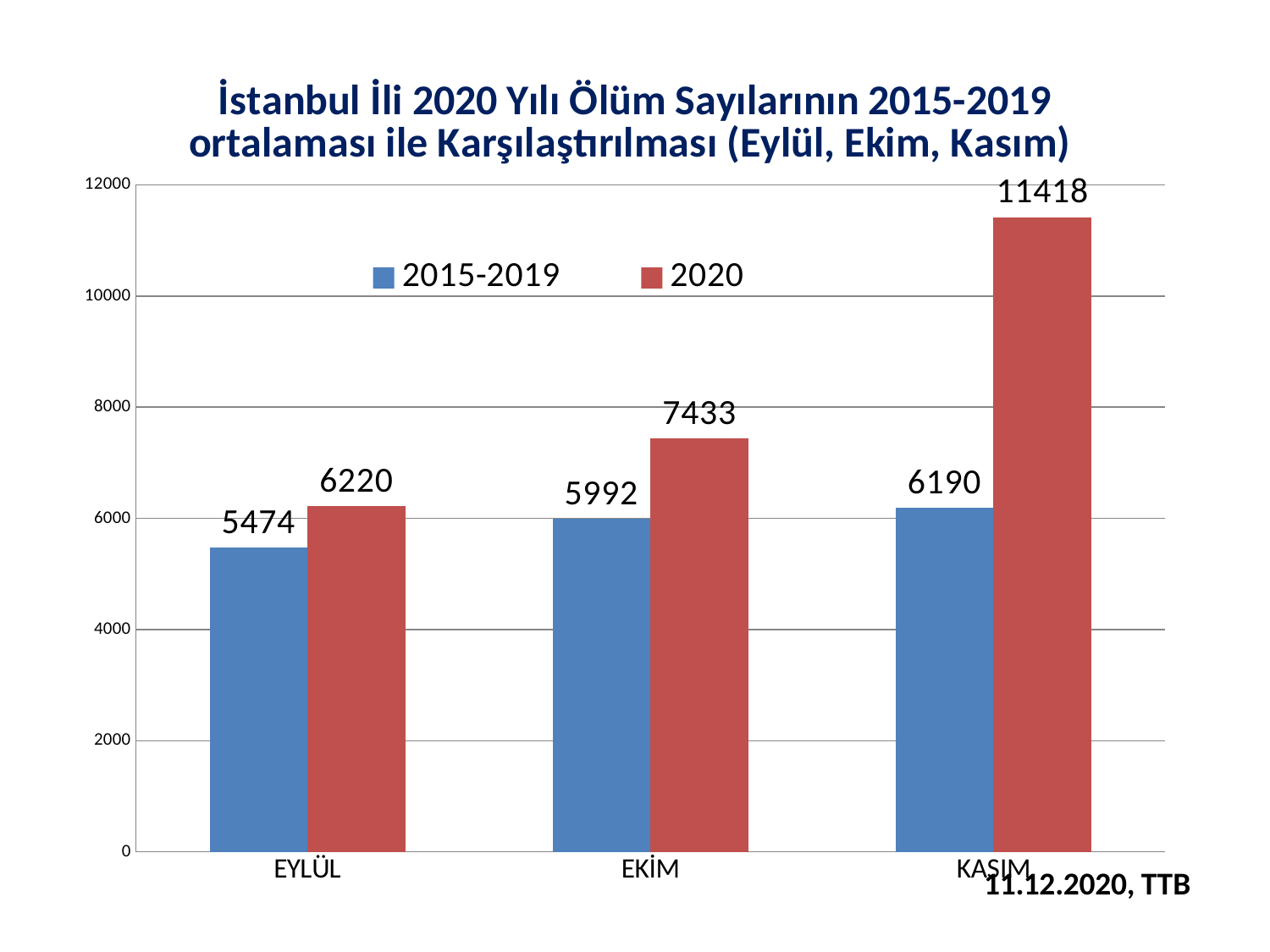
What is the difference between the 2020 and 2015-2019 values for EYLÜL? 746 What is the 2015-2019 value for KASIM? 6190 What is the 2020 value for EKİM? 7433 Which is larger for EKİM, the 2015-2019 value or the 2020 value? 2020 What is the difference between the 2020 and 2015-2019 values for KASIM? 5228 What is the 2015-2019 value for EYLÜL? 5474 What kind of chart is shown on the slide? Bar chart Which month has the highest 2020 value? KASIM How many months are shown on the x axis? 3 How many series does the legend list? 2 What is the 2020 value for KASIM? 11418 Which month has the lowest 2015-2019 value? EYLÜL